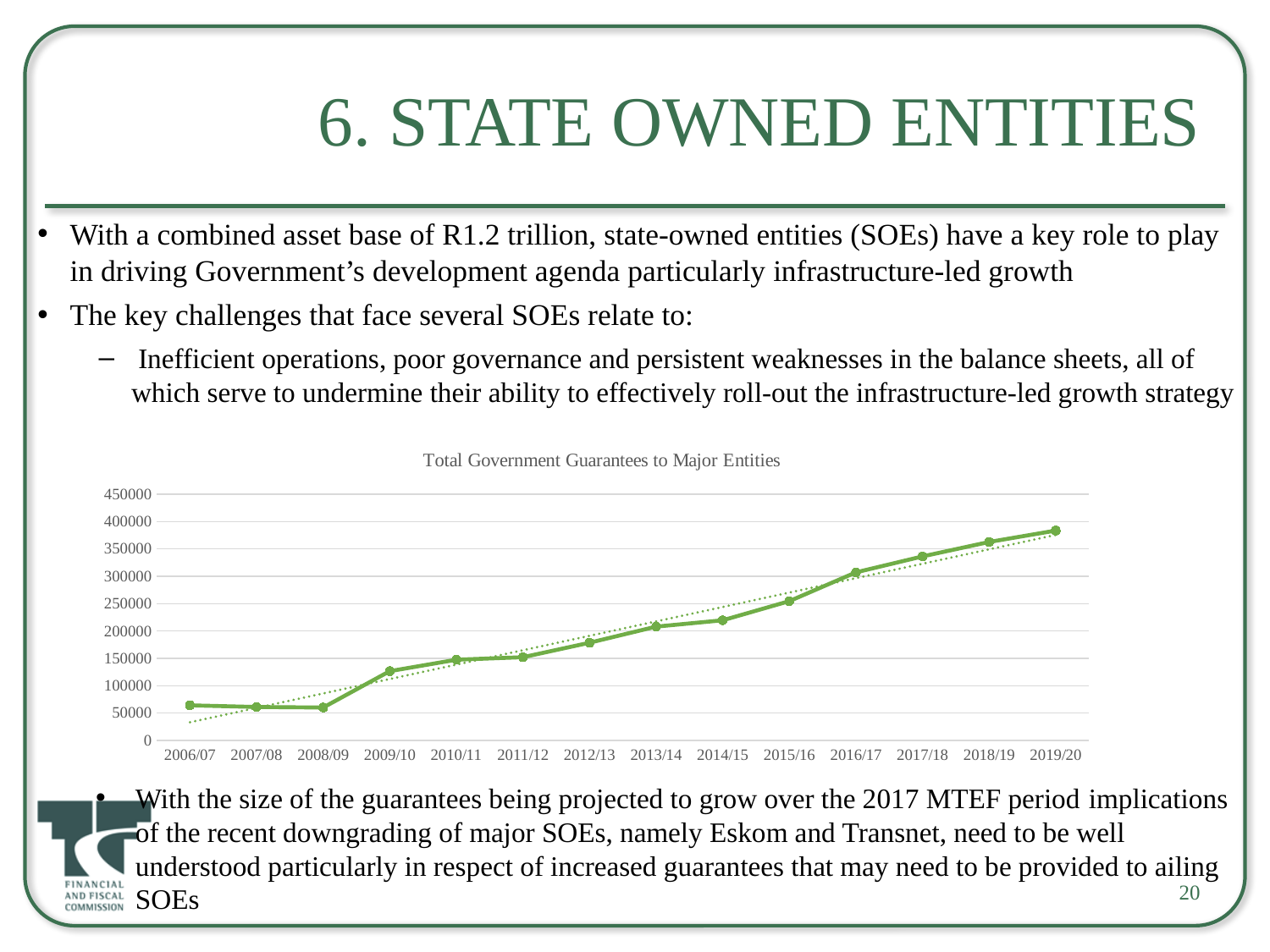
Do the values in the chart generally rise or fall from 2006/07 to 2019/20? rise How many financial years are plotted along the x axis of the chart? 14 Is the value for 2009/10 greater or less than 100000? greater What is the title of the chart? Total Government Guarantees to Major Entities Which financial year has the highest value in the chart? 2019/20 Is the value for 2007/08 greater or less than 100000? less What is the highest value shown on the y axis of the chart? 450000 Which is larger, the value for 2016/17 or the value for 2009/10? 2016/17 What kind of chart is shown on the slide? line chart Is the value for 2016/17 greater or less than 250000? greater